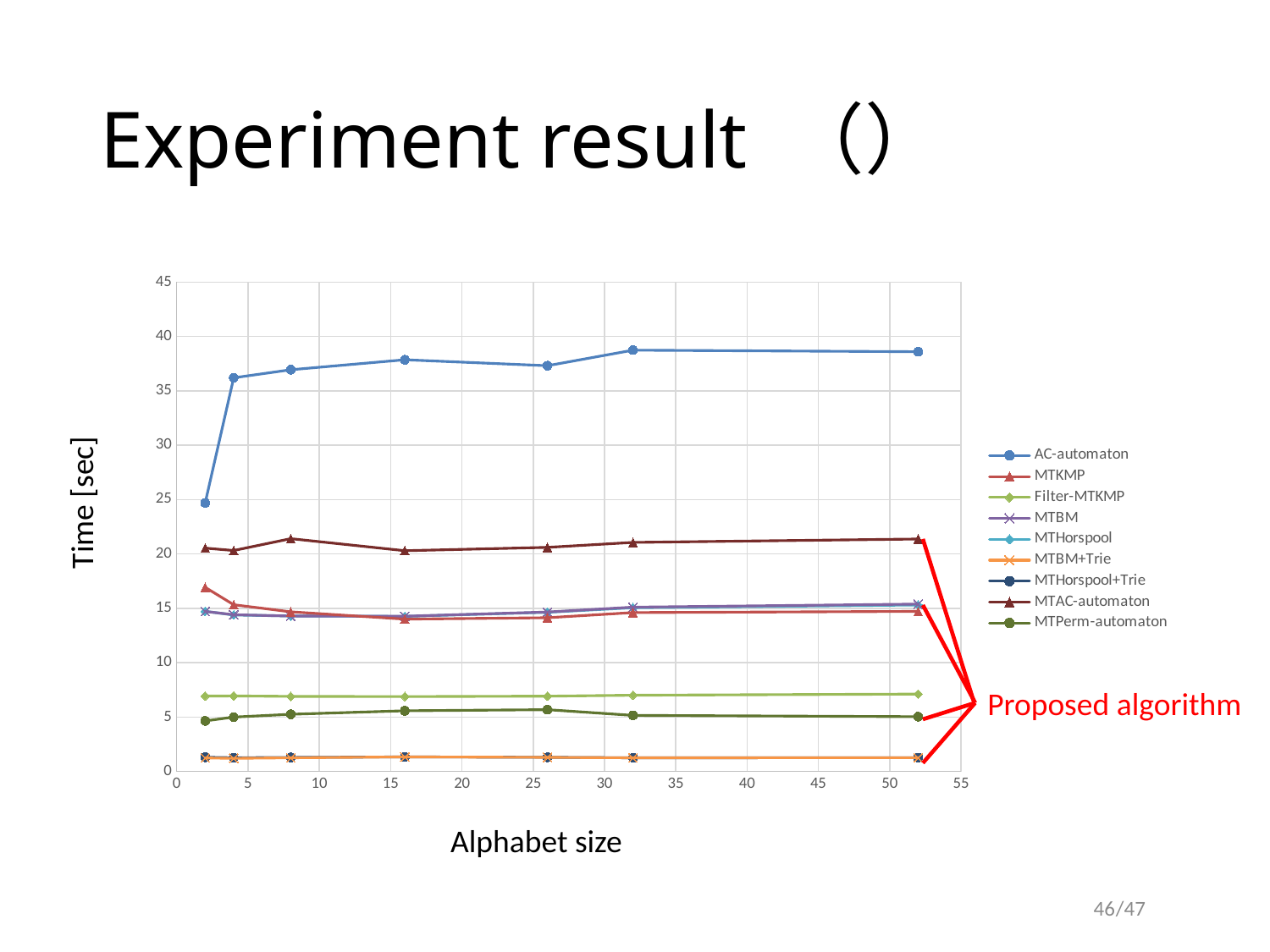
Does the AC-automaton series rise or fall as alphabet size increases from 2 to 52? rise How many series does the legend list? 9 What kind of chart is shown on the slide? line chart Is the value for AC-automaton at alphabet size 52 greater or less than 35? greater What is the label of the x axis? Alphabet size Which series has the highest time values across all alphabet sizes? AC-automaton Which is larger at alphabet size 52: AC-automaton or MTAC-automaton? AC-automaton Is the value for Filter-MTKMP at alphabet size 52 greater or less than 10? less What is the label of the y axis? Time [sec] Is the value for MTAC-automaton at alphabet size 52 greater or less than 15? greater Which is larger at alphabet size 52: Filter-MTKMP or MTPerm-automaton? Filter-MTKMP